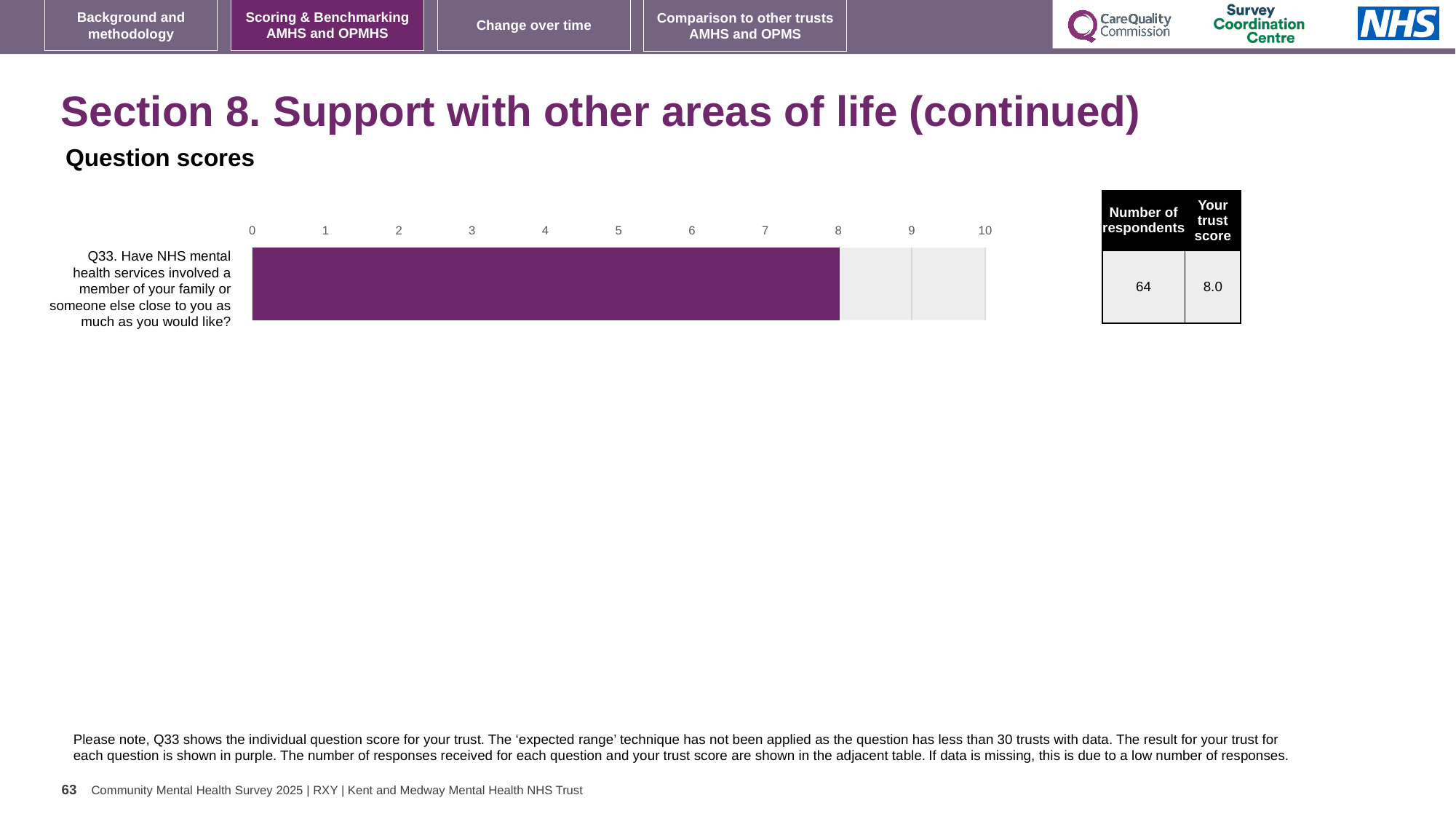
How many respondents answered Q33 according to the table next to the chart? 64 What colour is the bar for Q33? purple How many questions (bars) are plotted in the chart? 1 Is the value for Q33 greater or less than 9? less What is the maximum value shown on the chart's axis? 10 What is the trust score for Q33 shown in the chart? 8.0 Is the value for Q33 greater or less than 5? greater What kind of chart is shown on the slide? bar chart